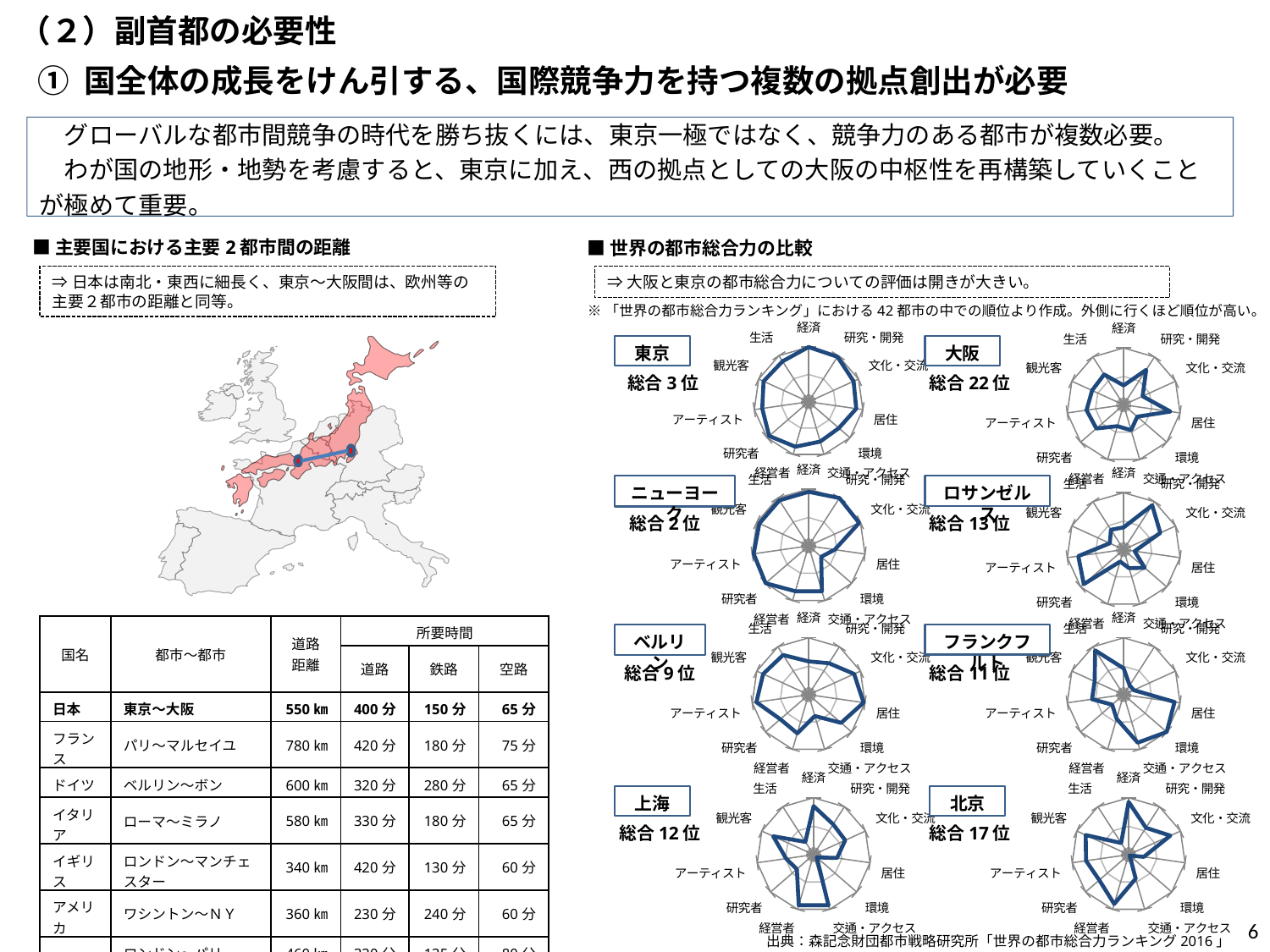
How many radar charts are shown in the '世界の都市総合力の比較' section? 8 In the '世界の都市総合力の比較' radar charts, what overall rank (総合) is shown for 北京? 総合 17 位 What kind of chart is used in the '世界の都市総合力の比較' section to compare the cities? Radar chart What source is cited below the radar charts in the '世界の都市総合力の比較' section? 森記念財団都市戦略研究所「世界の都市総合力ランキング 2016」 Among the eight cities in the '世界の都市総合力の比較' radar charts, which city has the best (lowest-numbered) overall rank? ニューヨーク In the '世界の都市総合力の比較' radar charts, how many rank positions separate 東京 (総合 3 位) and 大阪 (総合 22 位)? 19 In the '世界の都市総合力の比較' radar charts, what overall rank (総合) is shown for 東京? 総合 3 位 In the '世界の都市総合力の比較' radar charts, what overall rank (総合) is shown for 上海? 総合 12 位 In the '世界の都市総合力の比較' radar charts, what overall rank (総合) is shown for 大阪? 総合 22 位 In the '世界の都市総合力の比較' radar charts, which city is ranked higher overall, ベルリン or フランクフルト? ベルリン Among the eight cities in the '世界の都市総合力の比較' radar charts, which city has the worst (highest-numbered) overall rank? 大阪 In the '世界の都市総合力の比較' radar charts, what overall rank (総合) is shown for ニューヨーク? 総合 2 位